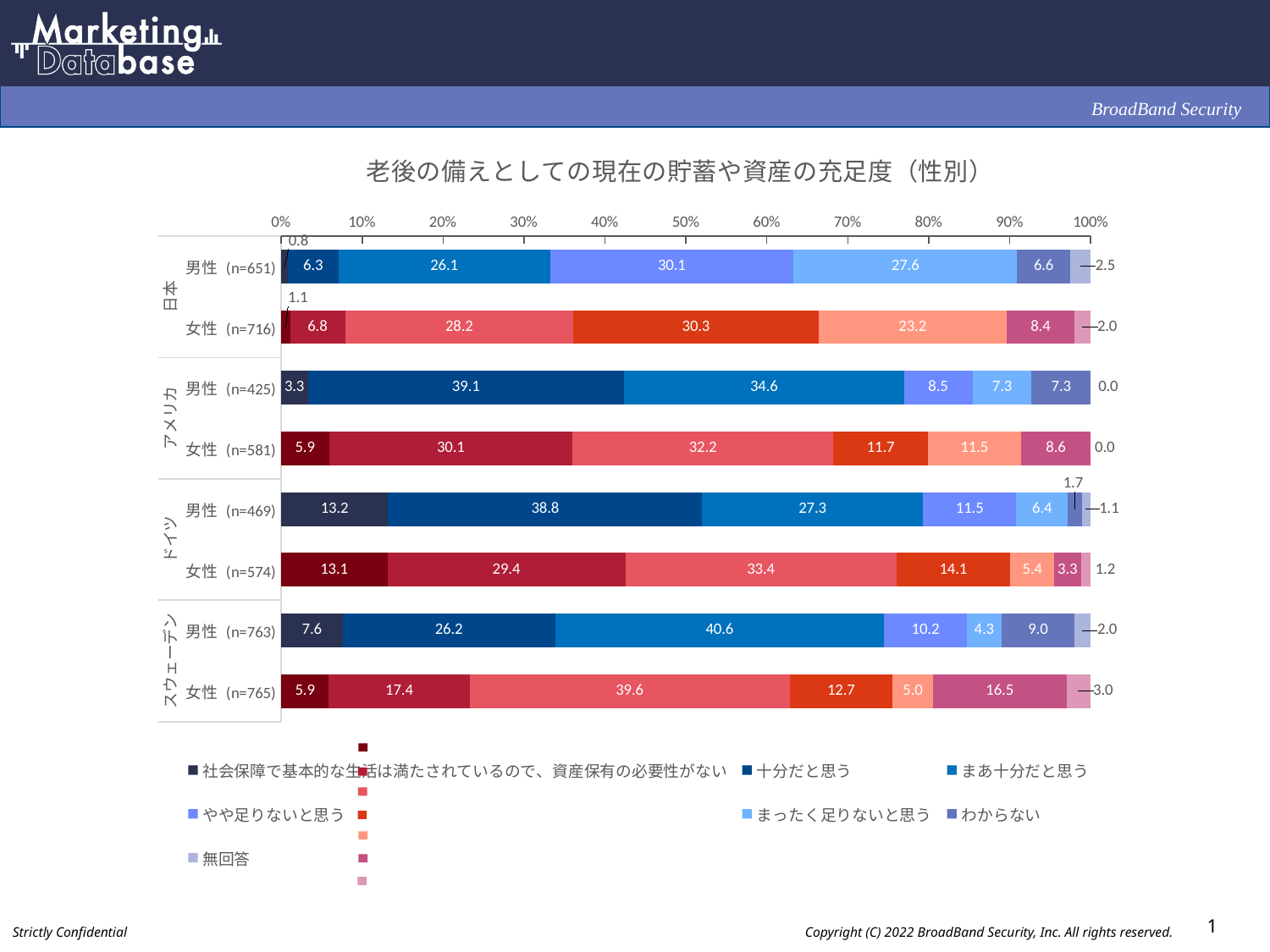
How many respondent groups (bars) are plotted in the chart? 8 What is the value of 「わからない」 for スウェーデン 女性 (n=765)? 16.5 What kind of chart is shown on the slide? Stacked bar chart What is the difference between the 「やや足りないと思う」 values for 日本 女性 (n=716) and アメリカ 女性 (n=581)? 18.6 Which group has the highest value for 「まったく足りないと思う」? 日本 男性 (n=651) What is the value of 「まあ十分だと思う」 for スウェーデン 男性 (n=763)? 40.6 How many series are listed in the legend? 7 What is the value of 「十分だと思う」 for アメリカ 男性 (n=425)? 39.1 Which is larger: the 「まあ十分だと思う」 value for ドイツ 女性 (n=574) or for アメリカ 女性 (n=581)? ドイツ 女性 (n=574) Which group has the lowest value for 「十分だと思う」? 日本 男性 (n=651) What is the title of the chart? 老後の備えとしての現在の貯蓄や資産の充足度（性別） What is the value of 「社会保障で基本的な生活は満たされているので、資産保有の必要性がない」 for ドイツ 男性 (n=469)? 13.2